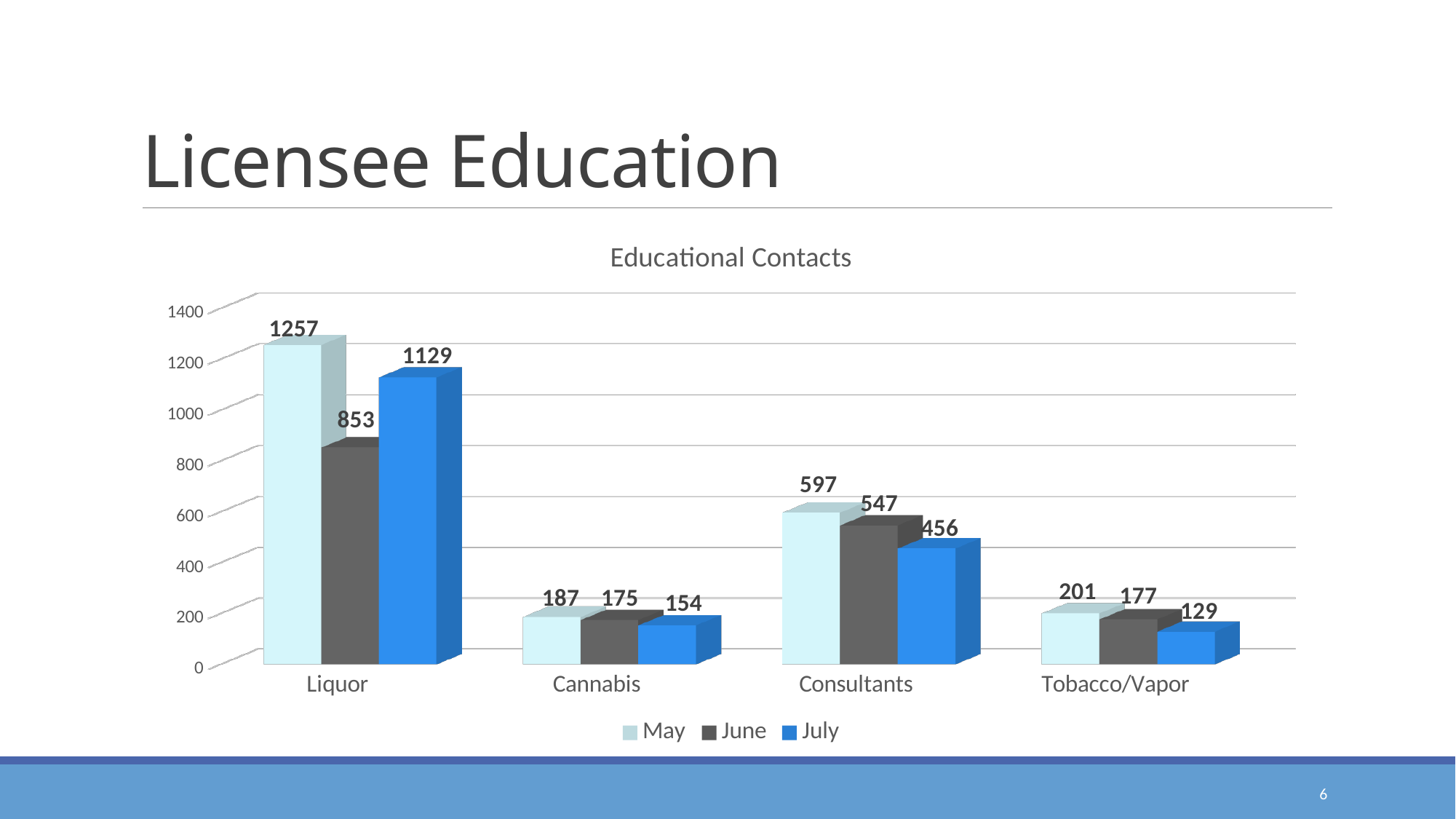
How many categories are shown on the x axis? 4 What is the July value for Consultants? 456 What is the difference between the May and June values for Liquor? 404 Which is larger, the June value for Cannabis or the June value for Tobacco/Vapor? Tobacco/Vapor What kind of chart is shown? Bar chart What is the title of the chart? Educational Contacts Is the July value for Liquor greater or less than 1000? greater What is the June value for Tobacco/Vapor? 177 Which category has the highest May value? Liquor What is the May value for Liquor? 1257 How many series does the legend list? 3 Which category has the lowest July value? Tobacco/Vapor